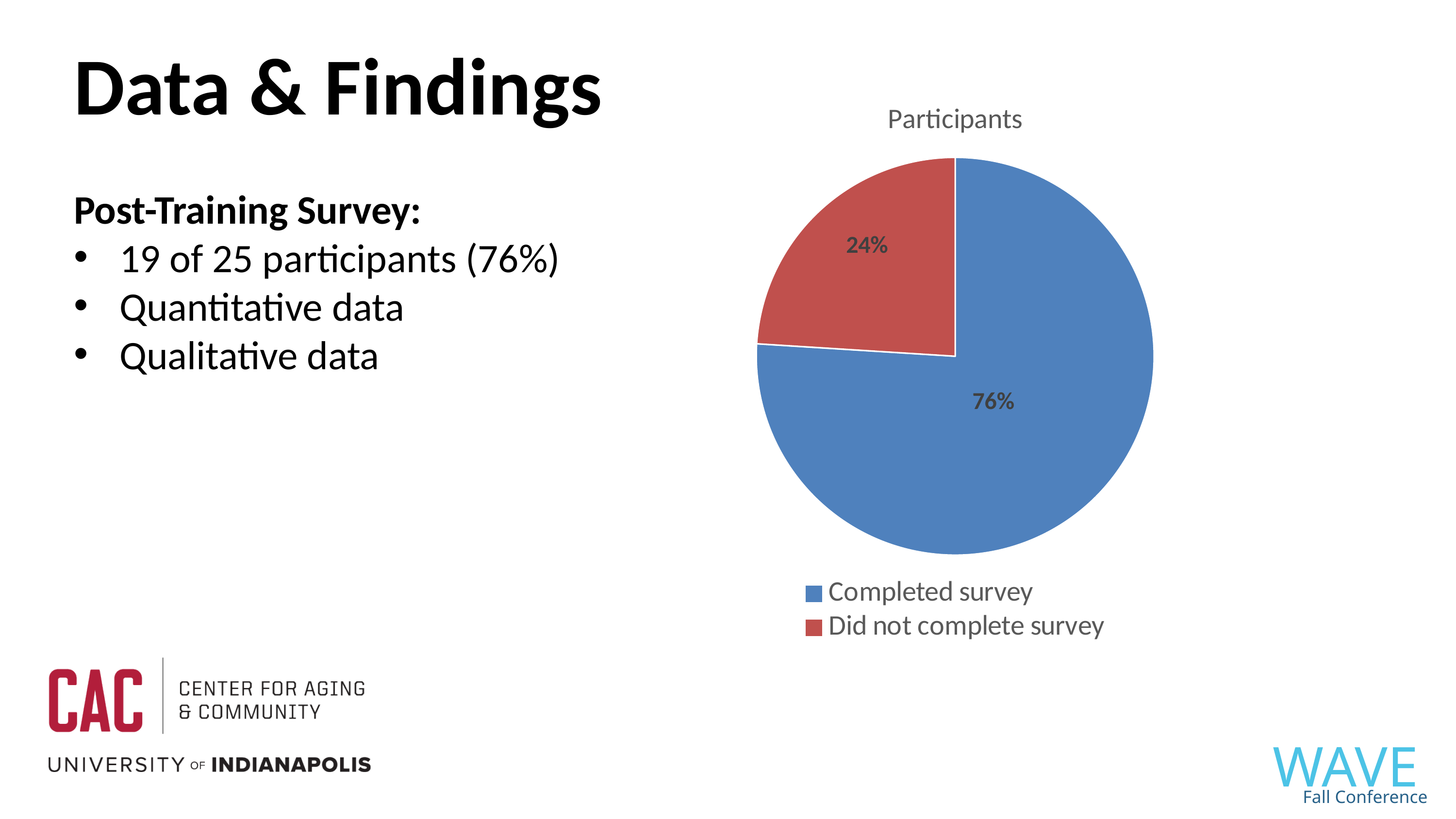
What share of the pie is labelled "Did not complete survey"? 24% What kind of chart is shown on the slide? pie chart How many slices does the pie chart have? 2 What share of the pie is labelled "Completed survey"? 76% What is the difference in percentage points between the "Completed survey" and "Did not complete survey" slices? 52 Which is larger, the "Completed survey" slice or the "Did not complete survey" slice? Completed survey What is the title of the chart? Participants What colour is the "Did not complete survey" slice? red Which slice of the pie is the largest? Completed survey Which slice of the pie is the smallest? Did not complete survey How many entries does the legend list? 2